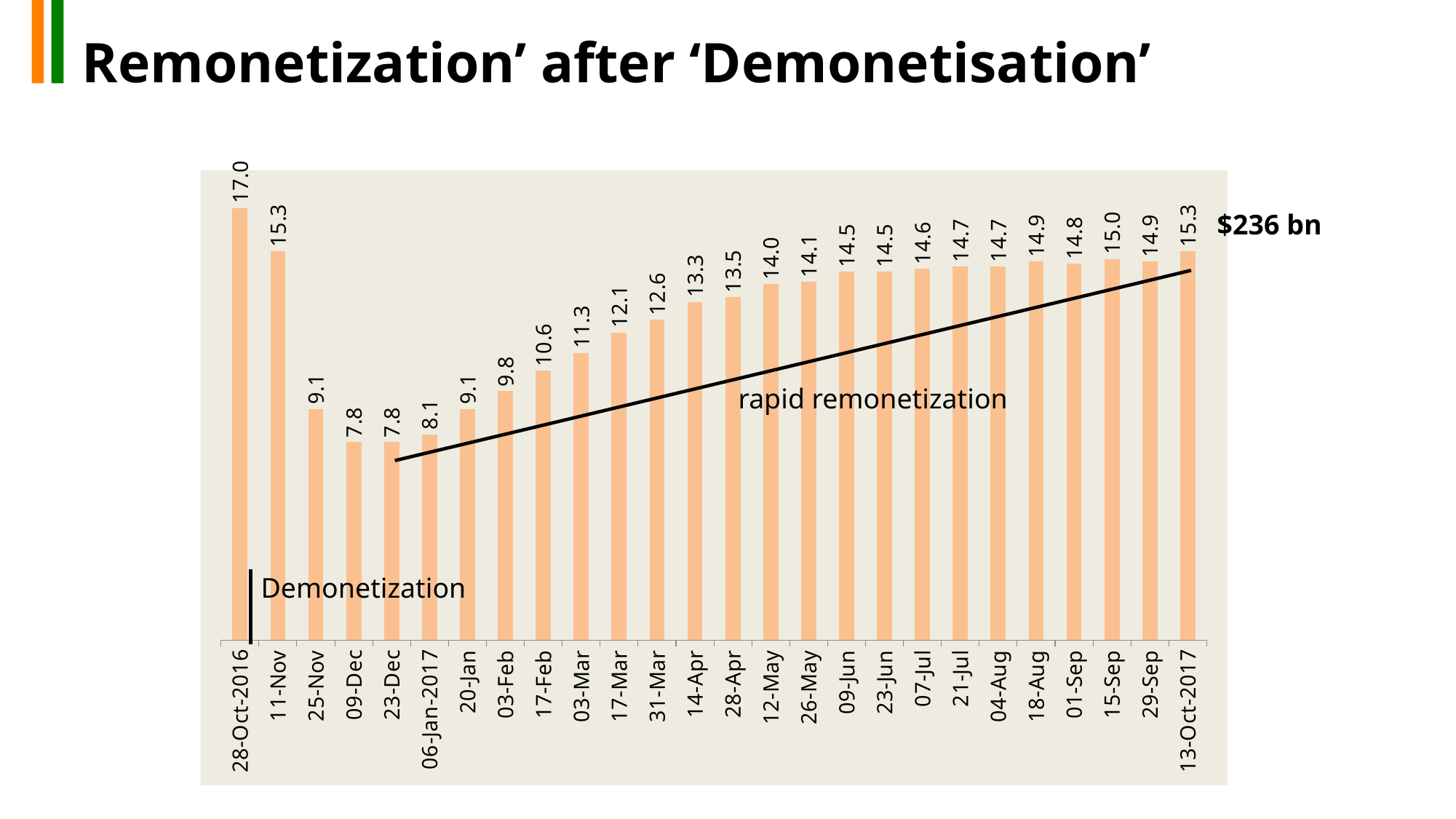
What is the value for 06-Jan-2017? 8.1 Do the values rise or fall from 23-Dec to 13-Oct-2017? Rise What is the value for 13-Oct-2017? 15.3 What is the difference between the values for 28-Oct-2016 and 11-Nov? 1.7 How many dates are shown on the x axis? 26 Which date has the highest value? 28-Oct-2016 What is the difference between the values for 13-Oct-2017 and 23-Dec? 7.5 Which is larger, the value for 03-Mar or the value for 31-Mar? 31-Mar What is the lowest value shown on the chart? 7.8 What is the value for 28-Oct-2016? 17.0 What is the value for 17-Feb? 10.6 What kind of chart is this? Bar chart